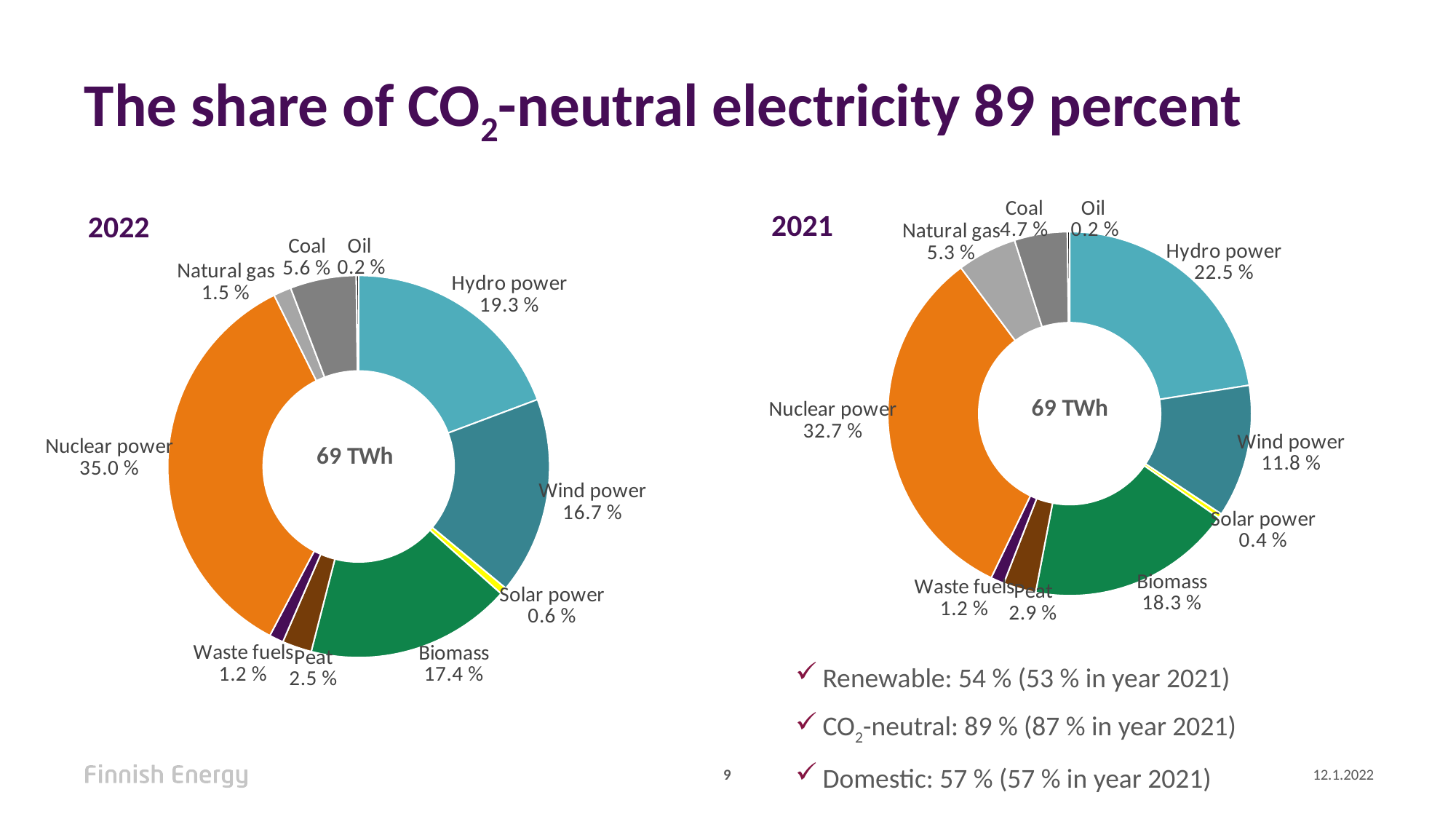
In the 2022 chart, what is the difference between the shares of Hydro power and Wind power? 2.6 % In the 2022 chart, what is the difference between the shares of Coal and Natural gas? 4.1 % What total value is printed in the centre of the 2021 chart? 69 TWh In the 2021 chart, which category has the smallest share? Oil In the 2022 chart, which category has the largest share? Nuclear power In the 2021 chart, what is the share of Natural gas? 5.3 % In the 2021 chart, what is the share of Hydro power? 22.5 % How many categories are shown in the 2022 chart? 10 In the 2021 chart, which is larger, the share of Biomass or the share of Wind power? Biomass What kind of chart is the 2022 chart? Donut (pie) chart In the 2022 chart, what is the share of Wind power? 16.7 % In the 2022 chart, what is the share of Nuclear power? 35.0 %